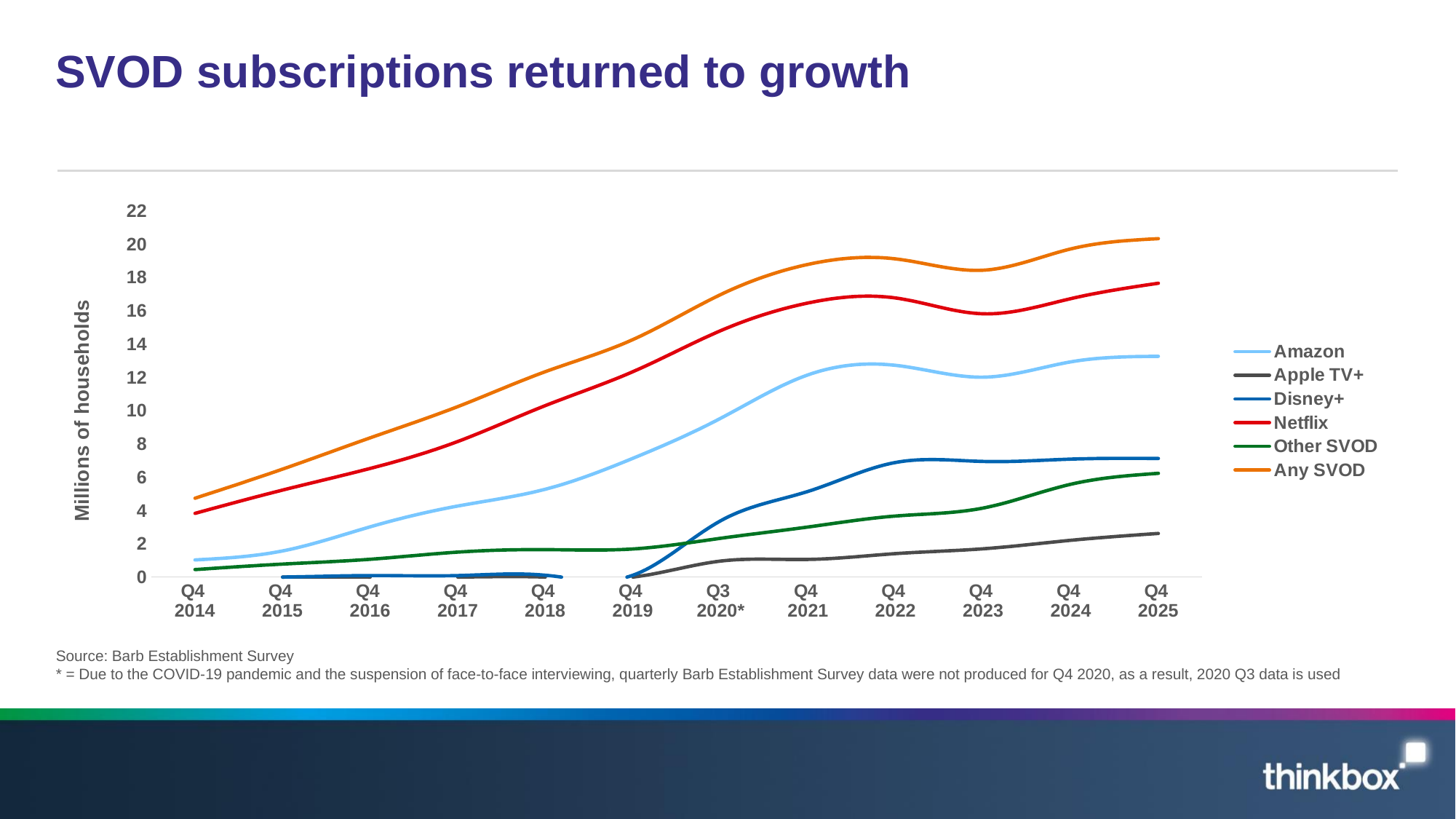
At Q4 2022, which is larger: Other SVOD or Apple TV+? Other SVOD Does the Netflix line rise or fall between Q4 2022 and Q4 2023? fall Is the value for Disney+ at Q4 2025 greater or less than 8? less How many series does the legend list? 6 What kind of chart is shown on the slide? line chart What is the label on the y axis? Millions of households Is the value for Any SVOD at Q4 2025 greater or less than 18? greater Which series has the highest value at Q4 2025? Any SVOD Which series has the lowest value at Q4 2025? Apple TV+ At Q4 2025, which is larger: Netflix or Amazon? Netflix How many time points are shown along the x axis? 12 Is the value for Netflix at Q4 2014 greater or less than 6? less